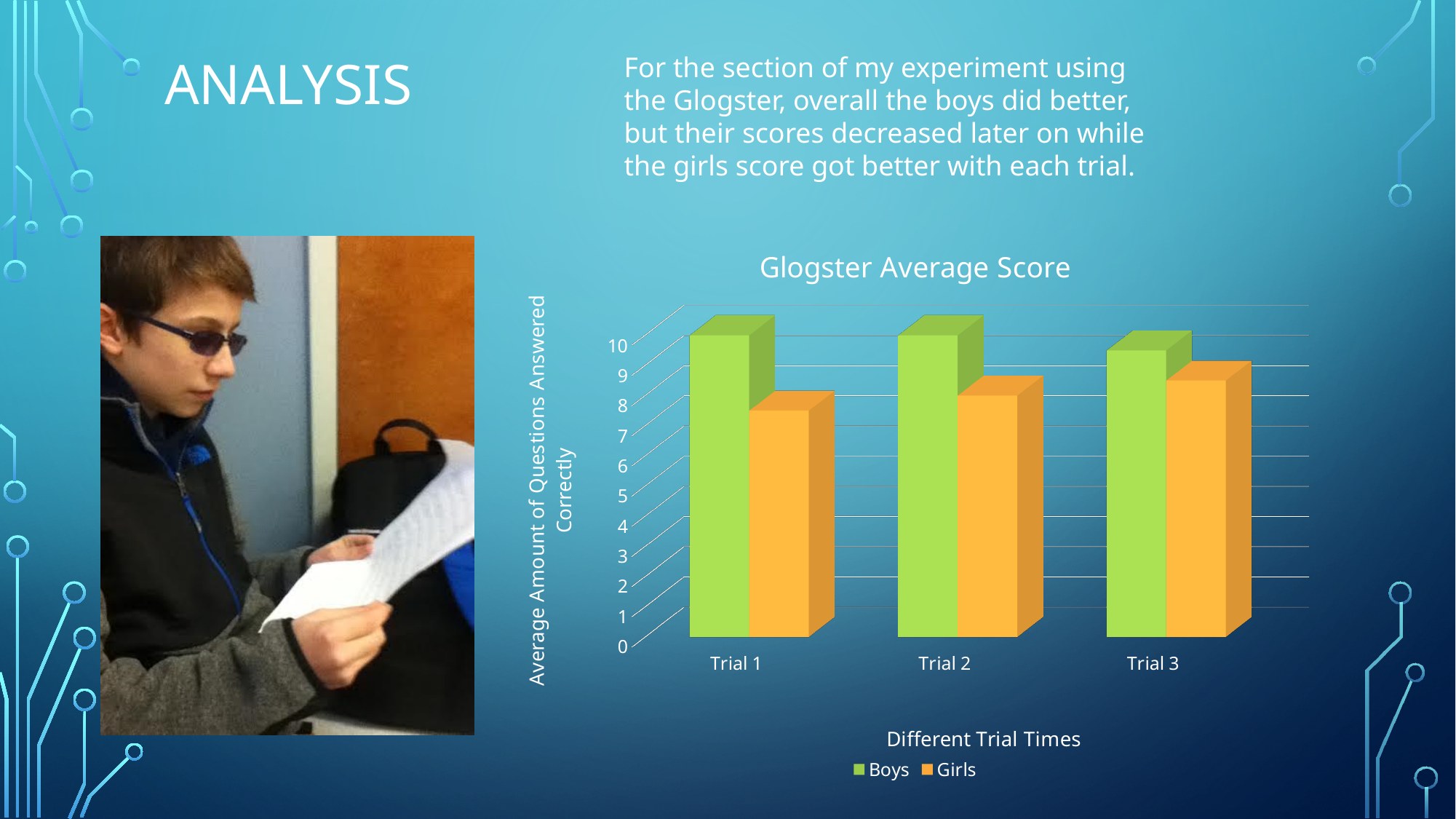
In Trial 1, which series has the higher value, Boys or Girls? Boys Do the Girls values rise or fall from Trial 1 to Trial 3? Rise In which trial is the Boys value the lowest? Trial 3 Is the Boys value for Trial 1 greater or less than 9? greater How many trials are shown on the x axis of the chart? 3 Which series is shown in orange in the chart? Girls How many series does the chart's legend list? 2 What is the title of the chart? Glogster Average Score What kind of chart is shown on the slide? Bar chart In Trial 3, which series has the higher value, Boys or Girls? Boys In which trial is the Girls value the lowest? Trial 1 In which trial is the Girls value the highest? Trial 3